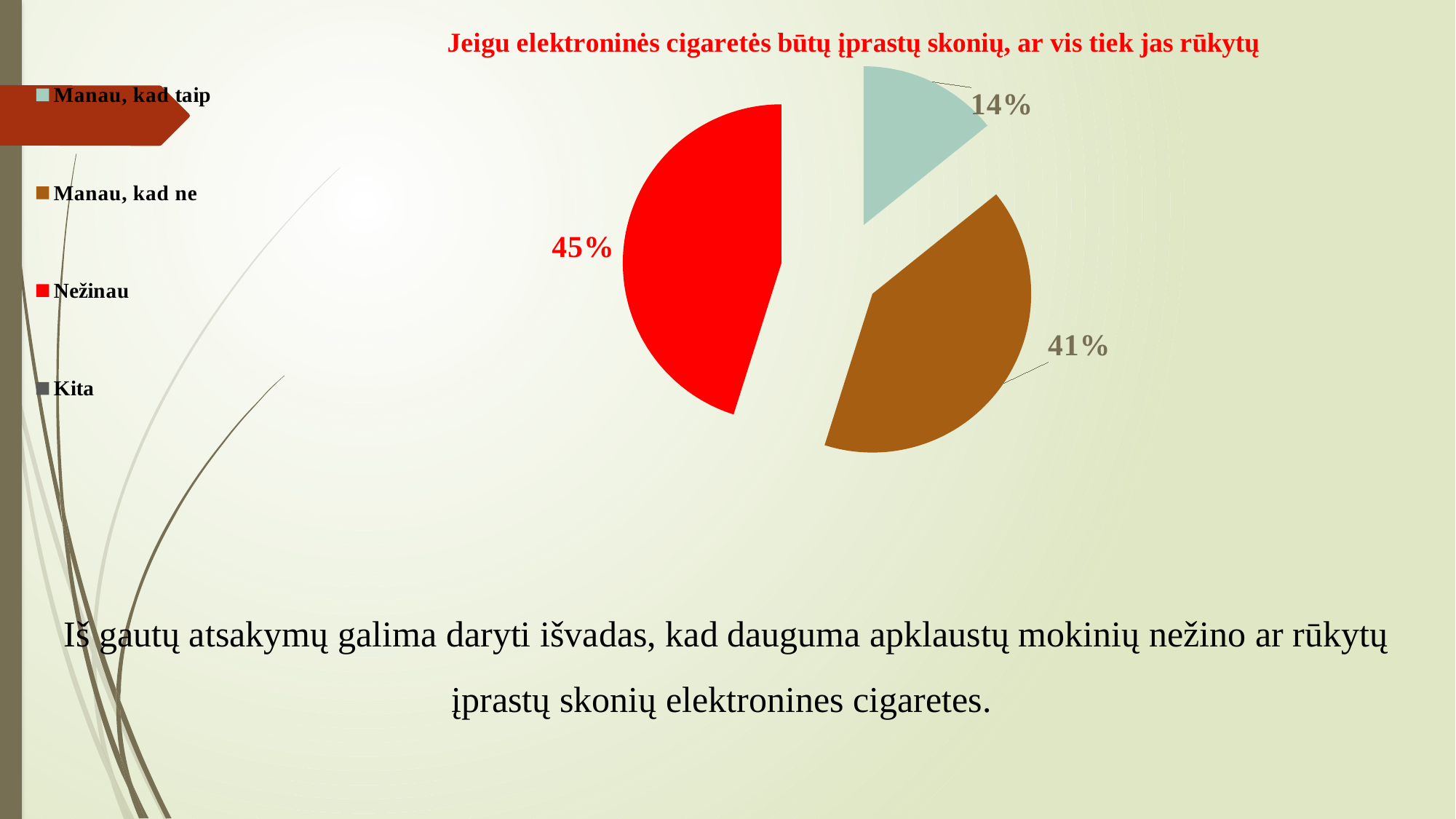
What colour is the slice for "Nežinau"? Red How many slices with percentage labels are shown in the pie? 3 What percentage of respondents answered "Manau, kad taip"? 14% What kind of chart is shown on the slide? Pie chart How many entries does the chart legend list? 4 What is the difference in percentage points between "Manau, kad ne" and "Manau, kad taip"? 27 Which answer has the largest share of the pie? Nežinau What is the difference in percentage points between "Nežinau" and "Manau, kad ne"? 4 What percentage of respondents answered "Manau, kad ne"? 41% What percentage of respondents answered "Nežinau"? 45% Which of the labelled slices has the smallest share? Manau, kad taip Which is larger, the share for "Manau, kad taip" or the share for "Manau, kad ne"? Manau, kad ne